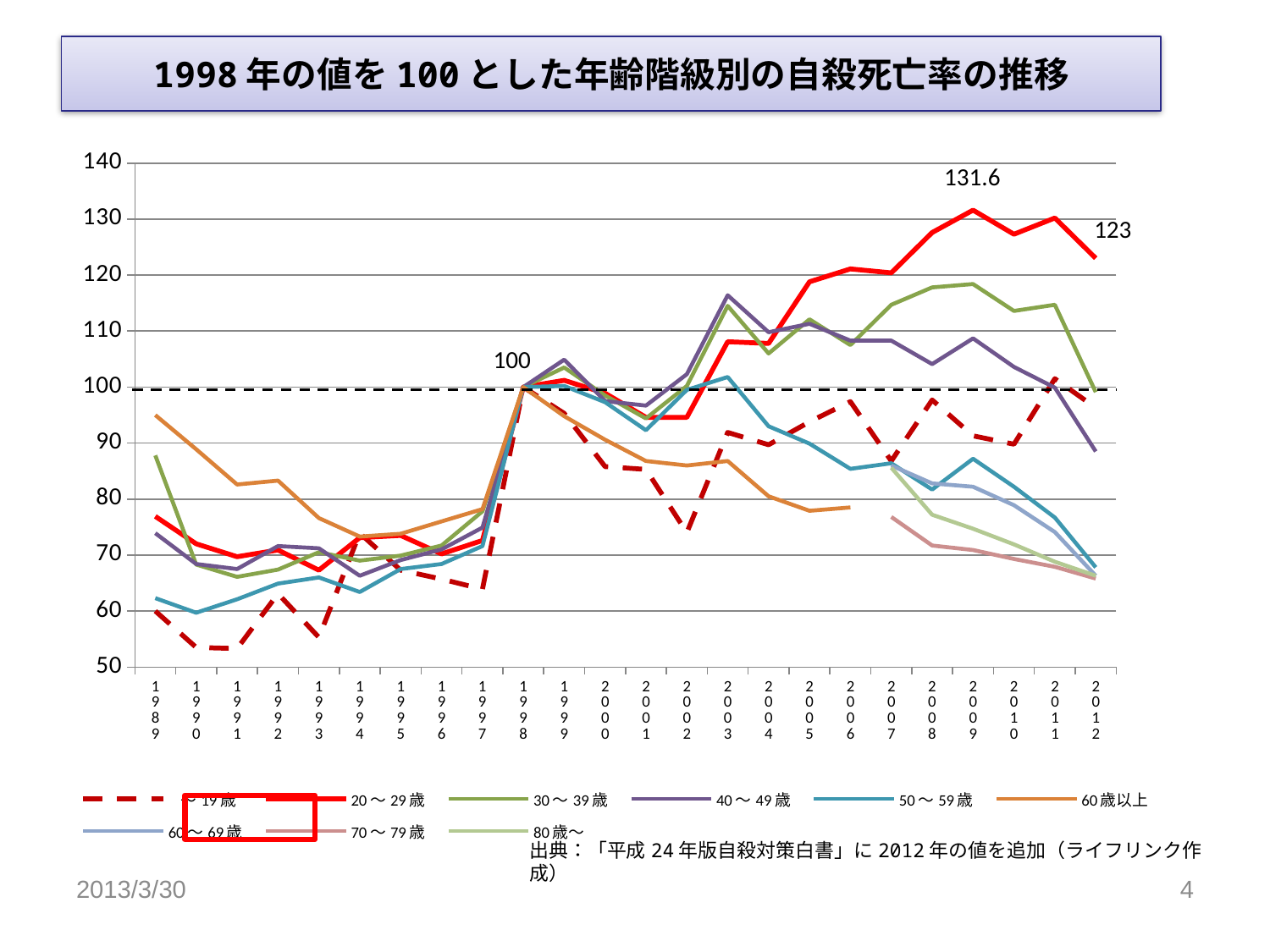
What is the value labelled for the 20～29歳 line in 2012? 123 Which age group has the highest value in 2012? 20～29歳 What is the peak value labelled on the 20～29歳 line? 131.6 How many years are shown on the x axis? 24 Is the value for 40～49歳 in 2003 greater or less than 110? greater Is the value for ～19歳 in 1991 greater or less than 60? less What is the difference between the labelled peak of the 20～29歳 line (131.6) and its 2012 value (123)? 8.6 What kind of chart is shown on the slide? line chart How many series does the legend list? 9 What value does the dashed horizontal reference line mark? 100 Which age group has the lowest value in 1991? ～19歳 In 2012, which is larger: the value for 20～29歳 or the value for 30～39歳? 20～29歳